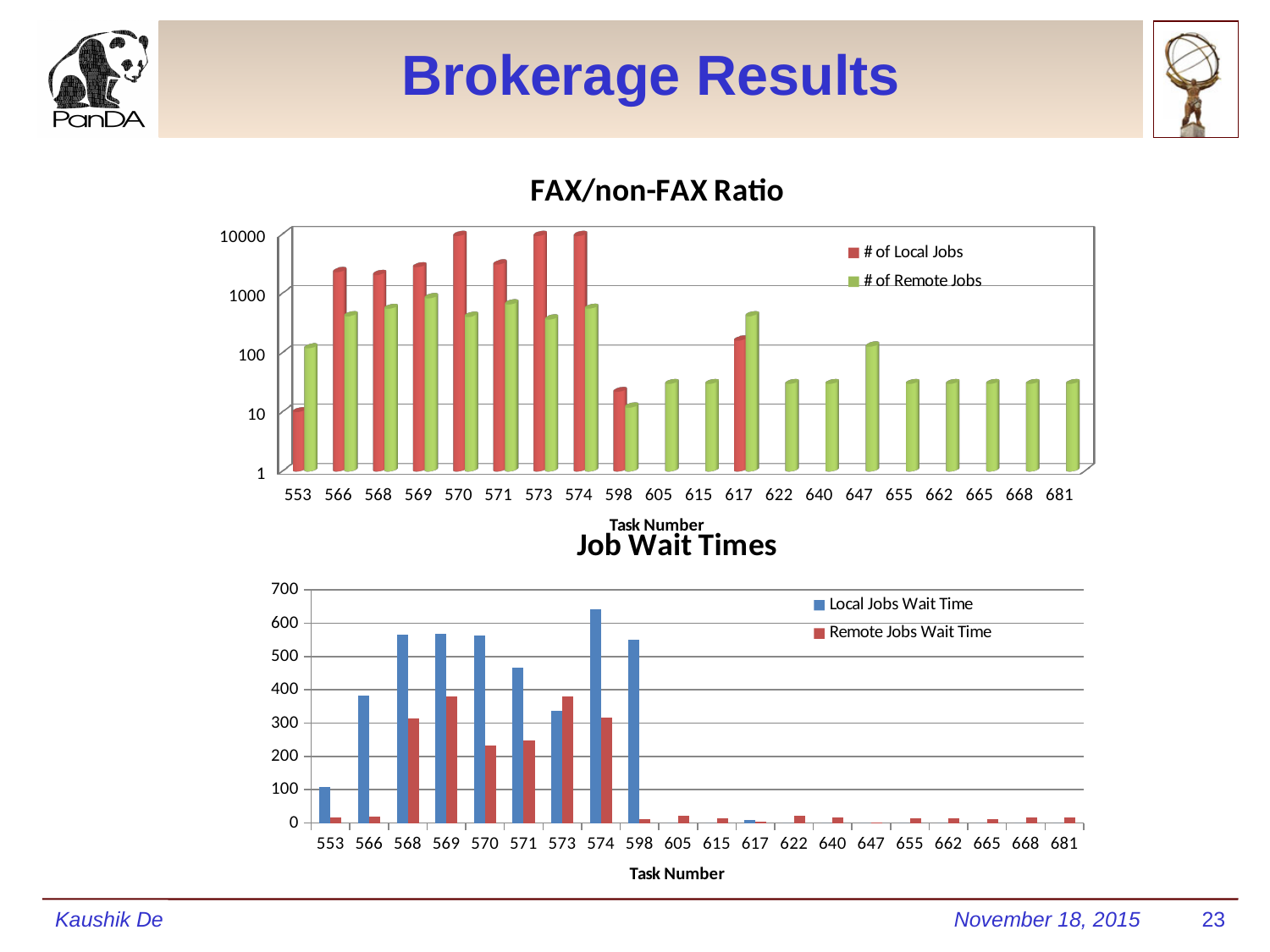
In the Job Wait Times chart, is the Remote Jobs Wait Time for task 570 greater or less than 300? less In the FAX/non-FAX Ratio chart, which is larger for task 566, the number of local jobs or the number of remote jobs? # of Local Jobs In the FAX/non-FAX Ratio chart, is the number of remote jobs for task 617 greater or less than 100? greater How many series does the legend of the Job Wait Times chart list? 2 What is the x-axis title of the Job Wait Times chart? Task Number In the Job Wait Times chart, which task number has the highest Local Jobs Wait Time? 574 What type of chart is the FAX/non-FAX Ratio chart? bar chart In the Job Wait Times chart, which task has the larger Remote Jobs Wait Time, 571 or 573? 573 In the FAX/non-FAX Ratio chart, is the number of local jobs for task 598 greater or less than 100? less How many task numbers are shown on the x axis of the Job Wait Times chart? 20 In the Job Wait Times chart, which is larger for task 568, the Local Jobs Wait Time or the Remote Jobs Wait Time? Local Jobs Wait Time